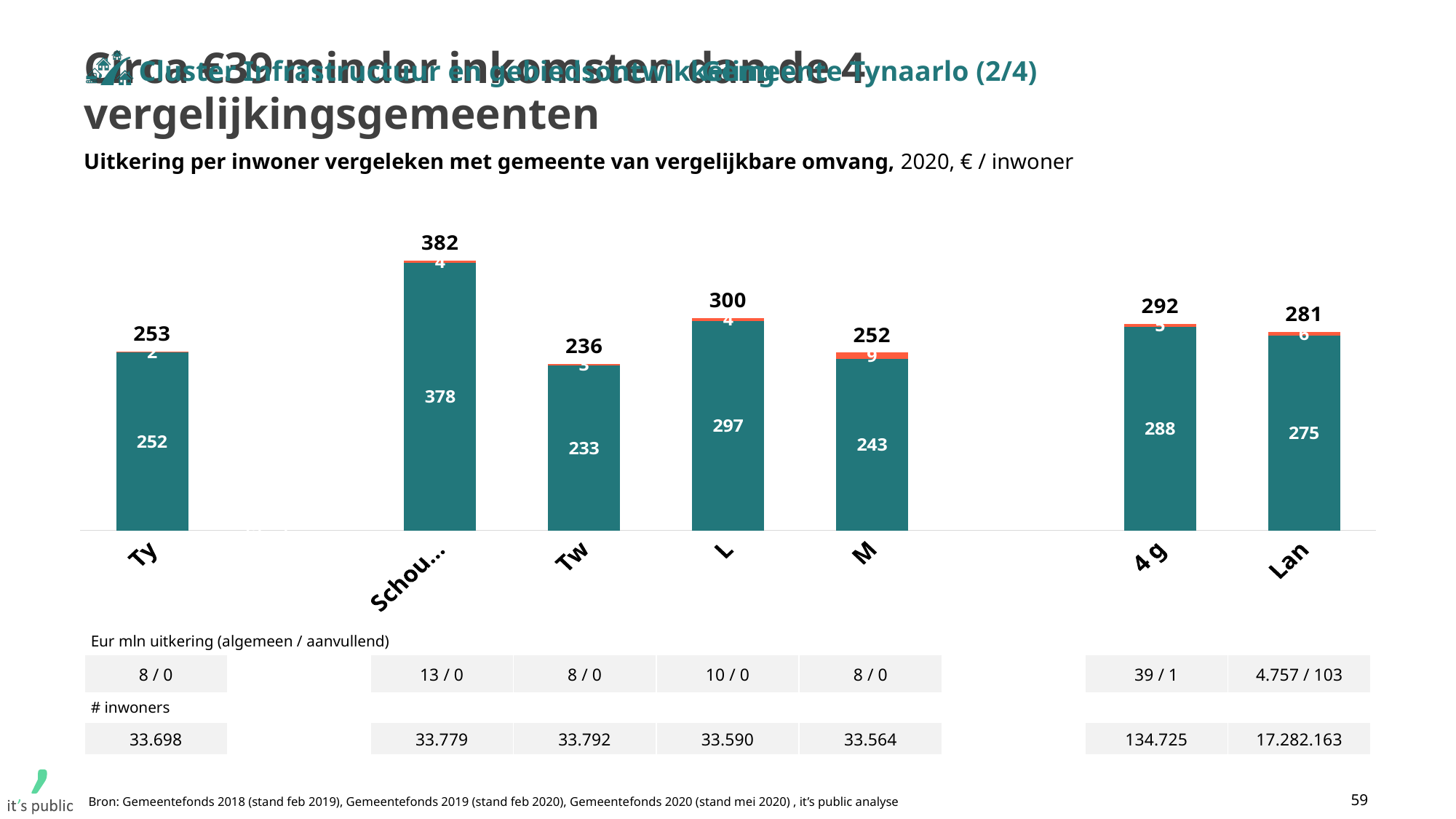
What is the difference between the total for L and the total for M? 48 How many bars are plotted in the chart? 7 Which category has the lowest total value? Tw What is the value of the orange (upper) segment of the bar for M? 9 What kind of chart is shown on the slide? Stacked bar chart What is the total value shown above the bar for Ty? 253 What is the value of the teal (lower) segment of the bar for 4 g? 288 Which category has the highest total value? Schou... What is the difference between the total for Schou... and the total for Ty? 129 Which has a larger total, L or 4 g? L What is the total value shown above the bar for Lan? 281 What is the value of the teal (lower) segment of the bar for M? 243